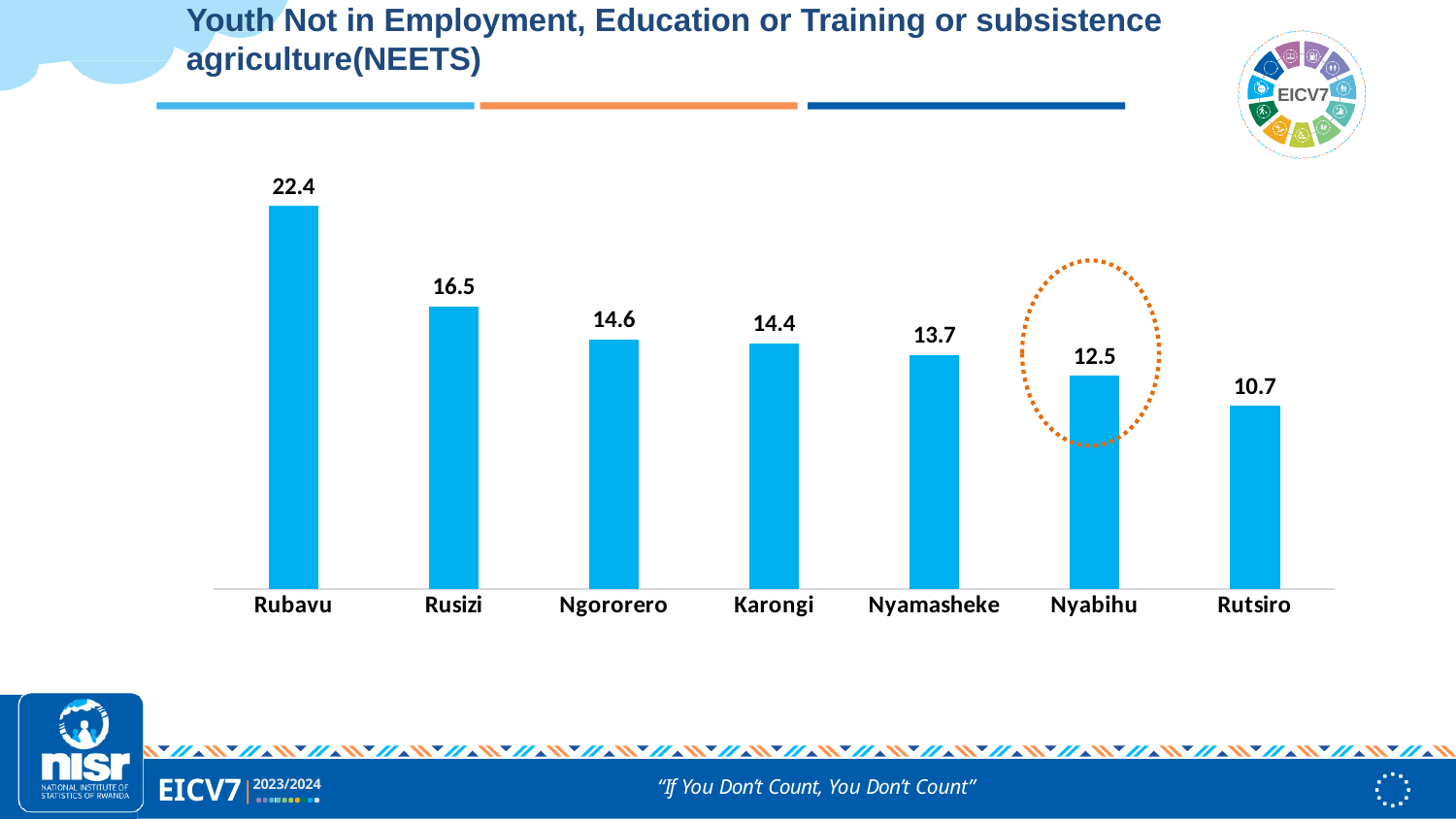
What is the value for Nyabihu? 12.5 Which district has the lowest value? Rutsiro Which district's bar is highlighted with a dotted orange circle? Nyabihu Which is larger, the value for Rusizi or the value for Ngororero? Rusizi Which district has the highest value? Rubavu What kind of chart is shown on the slide? Bar chart What is the value for Karongi? 14.4 How many districts are shown on the chart? 7 Do the values rise or fall from left to right across the districts? Fall What is the difference between the values for Rusizi and Nyamasheke? 2.8 What is the value for Rubavu? 22.4 What is the difference between the values for Rubavu and Rutsiro? 11.7